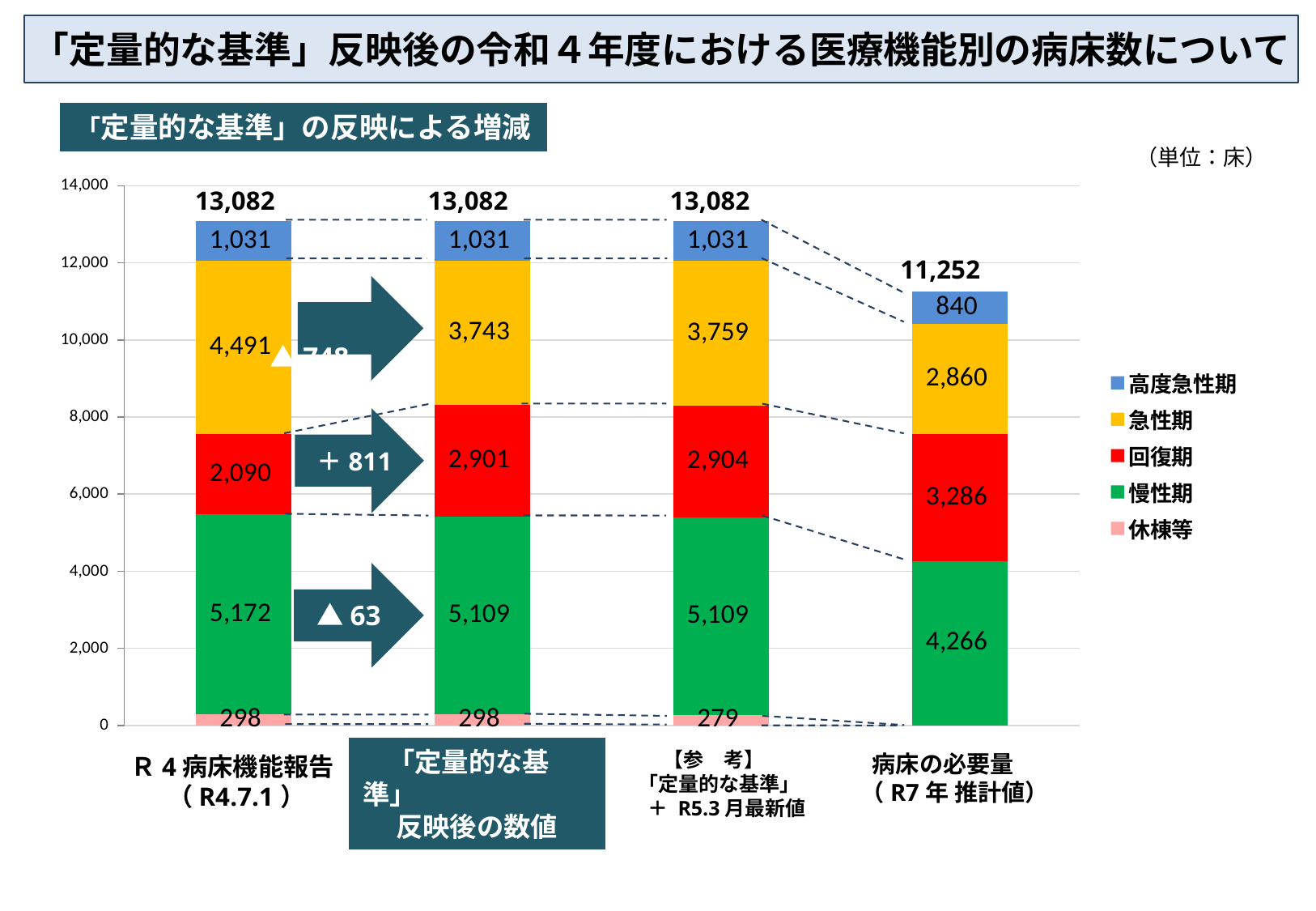
What kind of chart is shown on the slide? Stacked bar chart What is the total of the stacked bar for 病床の必要量（R7年推計値）? 11,252 What is the value of 慢性期 for 病床の必要量（R7年推計値）? 4,266 Which category has the lowest stacked total? 病床の必要量（R7年推計値） What is the value of 高度急性期 for 病床の必要量（R7年推計値）? 840 What is the value of 休棟等 for 【参考】「定量的な基準」＋R5.3月最新値? 279 What is the value of 急性期 for R４病床機能報告（R4.7.1）? 4,491 What is the value of 回復期 for 「定量的な基準」反映後の数値? 2,901 How many series does the legend list? 5 Is the 急性期 value larger for 【参考】「定量的な基準」＋R5.3月最新値 or for 「定量的な基準」反映後の数値? 【参考】「定量的な基準」＋R5.3月最新値 What is the difference in 回復期 between 「定量的な基準」反映後の数値 and R４病床機能報告（R4.7.1）? 811 Which category has the highest value for 慢性期? R４病床機能報告（R4.7.1）